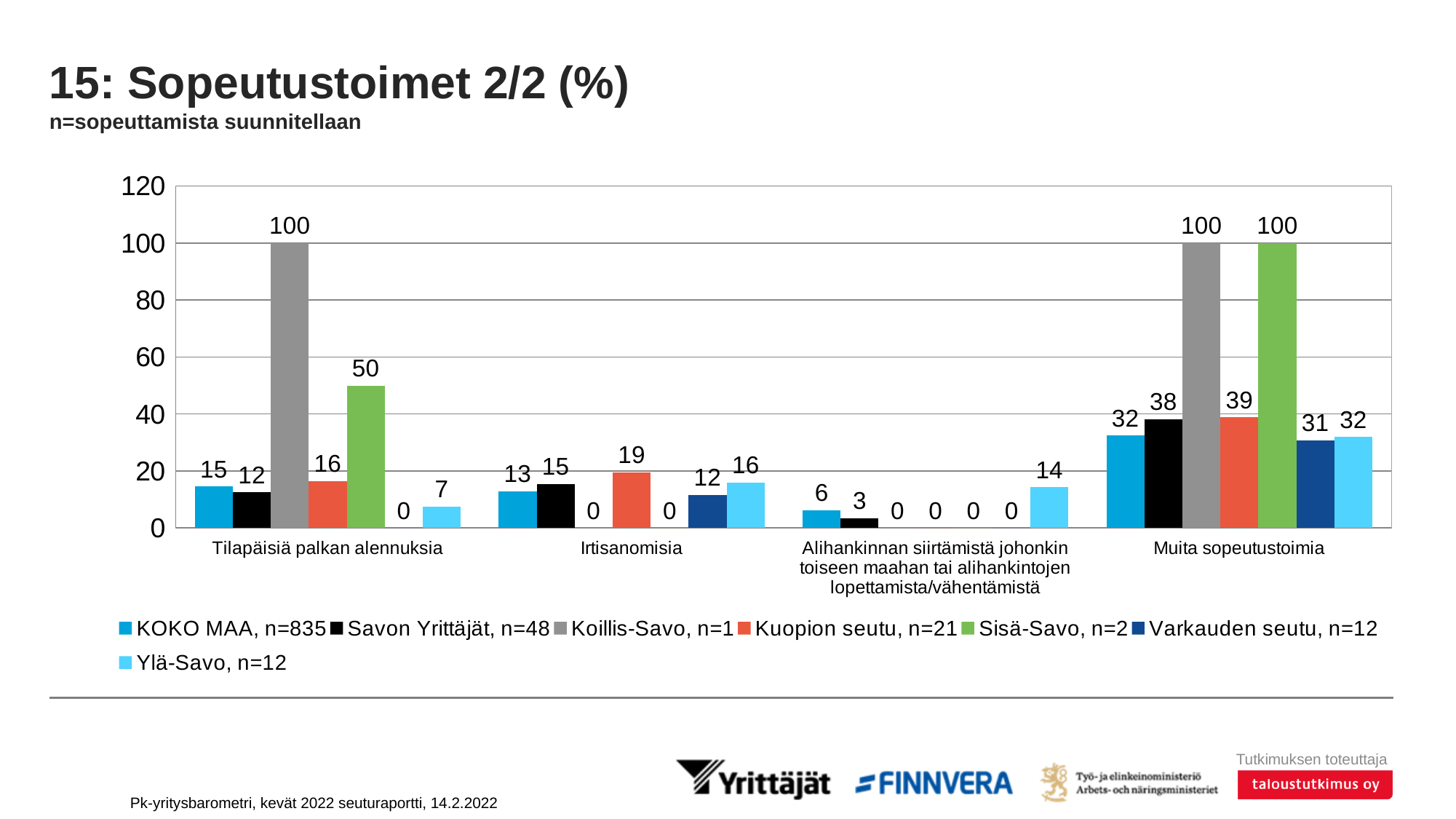
How many categories are shown on the x axis? 4 What is the difference between the Sisä-Savo and Kuopion seutu values in the Tilapäisiä palkan alennuksia category? 34 What is the value for Kuopion seutu in the Irtisanomisia category? 19 What is the value for KOKO MAA in the Tilapäisiä palkan alennuksia category? 15 What is the sample size (n) given in the legend for KOKO MAA? 835 Which series has the lowest value in the Irtisanomisia category? Koillis-Savo, n=1 and Sisä-Savo, n=2 (both 0) What is the value for Ylä-Savo in the Alihankinnan siirtämistä johonkin toiseen maahan tai alihankintojen lopettamista/vähentämistä category? 14 Which series has the highest value in the Tilapäisiä palkan alennuksia category? Koillis-Savo, n=1 In the Muita sopeutustoimia category, which is larger: the value for Kuopion seutu or the value for Varkauden seutu? Kuopion seutu What is the value for Savon Yrittäjät in the Muita sopeutustoimia category? 38 What kind of chart is shown on the slide? Bar chart How many series does the legend list? 7